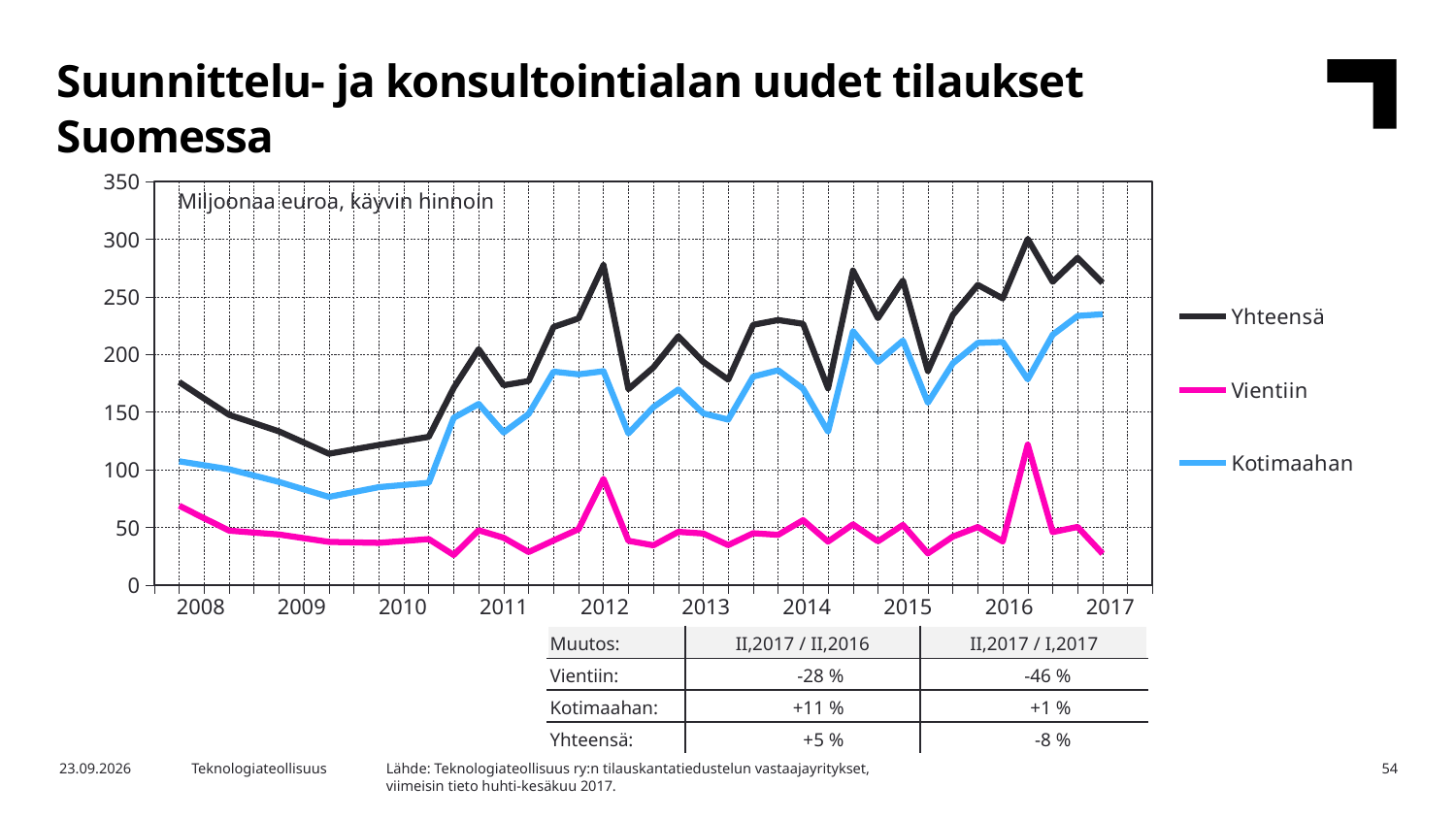
What unit label is printed inside the chart area? Miljoonaa euroa, käyvin hinnoin Does the Yhteensä line rise or fall from 2008 to 2009? fall Is the value of Kotimaahan at the last point in 2017 greater or less than 200? greater Which series has the lowest values throughout the chart? Vientiin Is the lowest value of Kotimaahan in 2009 greater or less than 100? less What kind of chart is shown on the slide? line chart How many series does the legend list? 3 Which series has the highest values throughout the chart? Yhteensä What are the three series named in the legend? Yhteensä, Vientiin, Kotimaahan Which series is higher at the start of 2008, Kotimaahan or Vientiin? Kotimaahan How many years are labelled on the x axis? 10 Is the peak value of Vientiin in 2016 greater or less than 100? greater